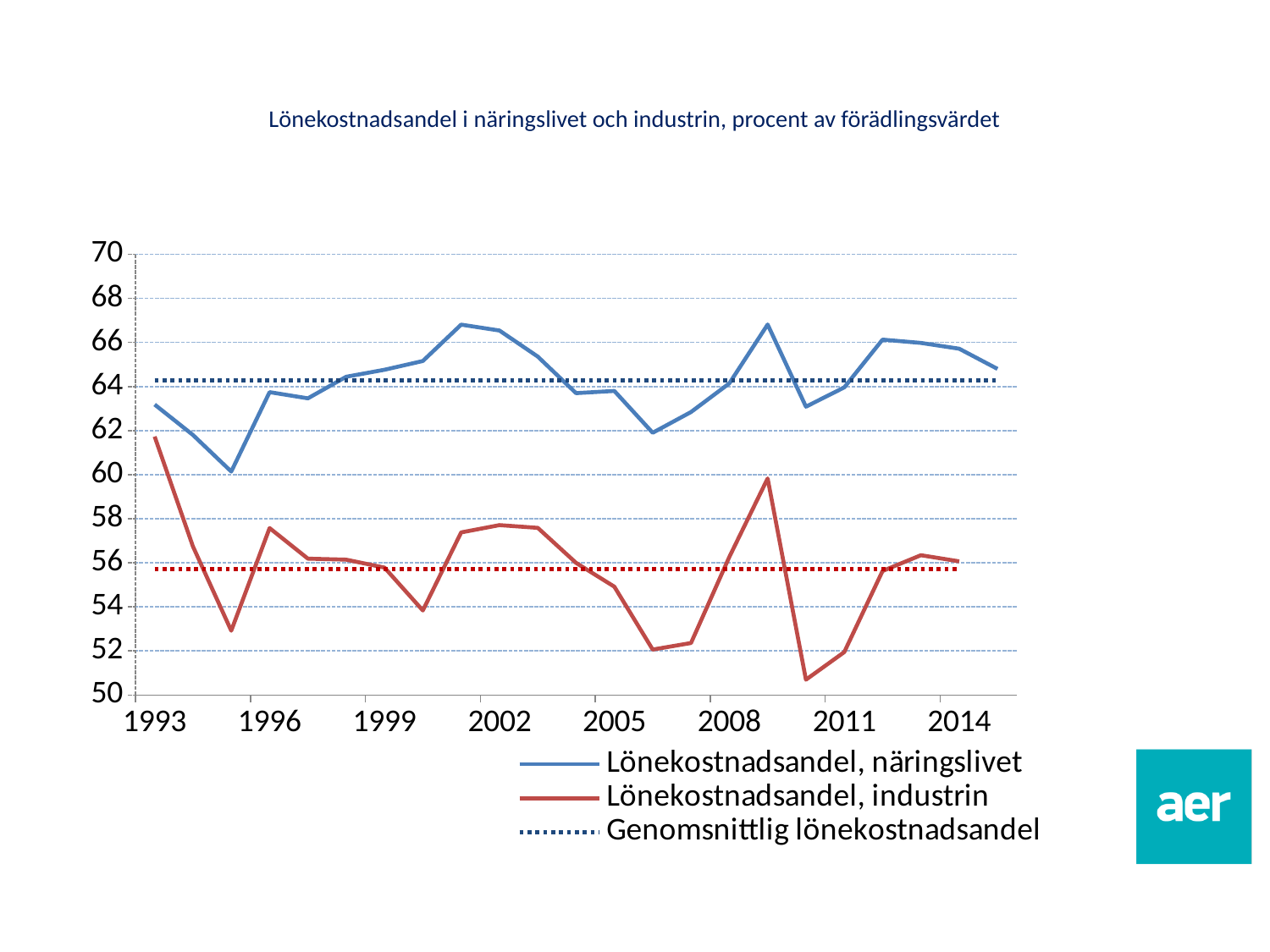
Is the value for Lönekostnadsandel, industrin in 1993 greater or less than 60? greater How many series does the legend list? 3 Which series has the higher value in 2009, Lönekostnadsandel, näringslivet or Lönekostnadsandel, industrin? Lönekostnadsandel, näringslivet Is the value for Lönekostnadsandel, näringslivet in 2001 greater or less than 66? greater Is the value for Lönekostnadsandel, näringslivet in 1995 greater or less than 62? less In which year is Lönekostnadsandel, näringslivet at its lowest? 1995 What kind of chart is shown on the slide? line chart In which year is Lönekostnadsandel, industrin at its lowest? 2010 What is the title of the chart? Lönekostnadsandel i näringslivet och industrin, procent av förädlingsvärdet What colour is the line for Lönekostnadsandel, industrin? red